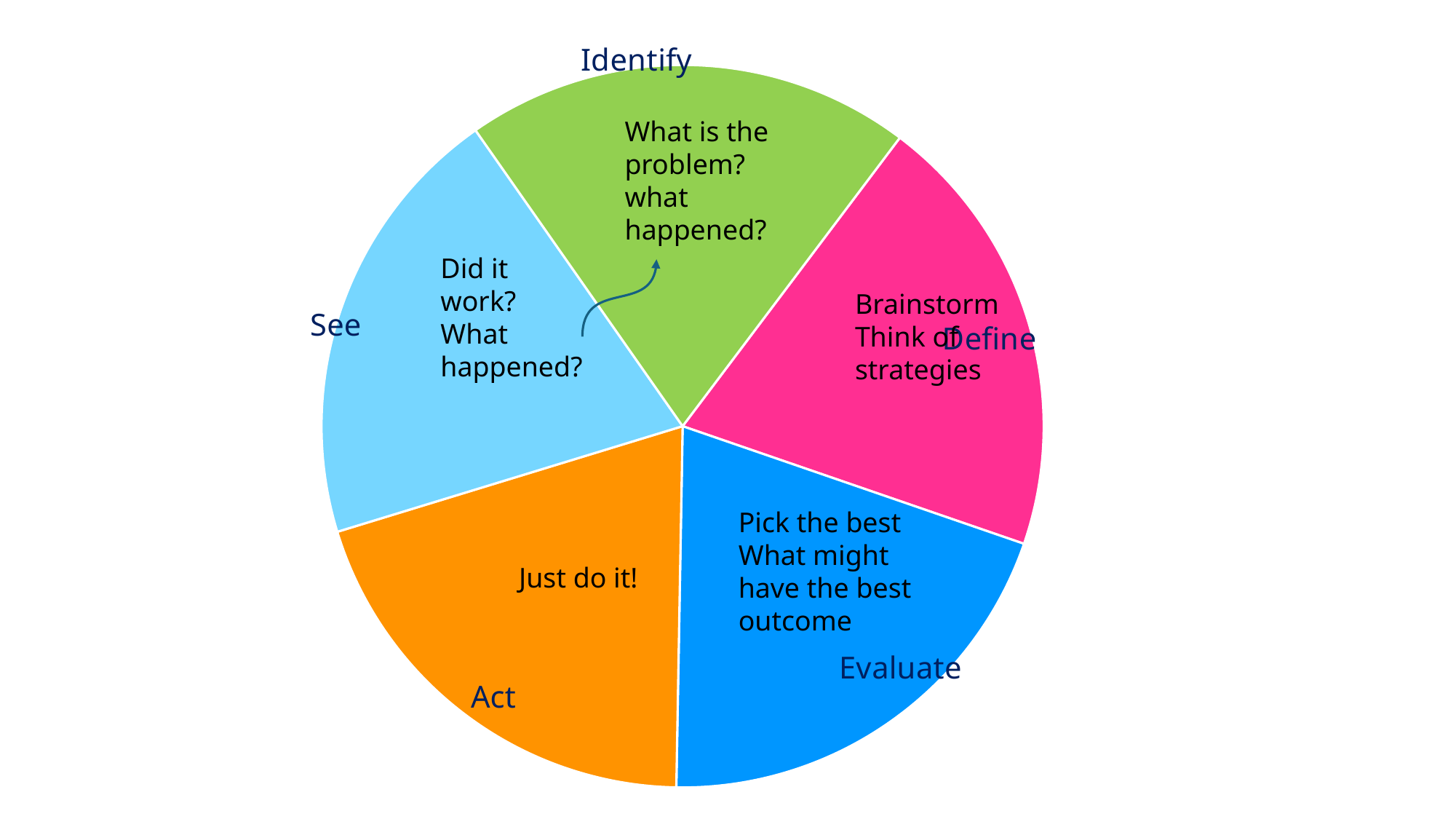
Which slice of the pie chart contains the text "Just do it!"? Act How many slices does the pie chart have? 5 Which slice of the pie chart contains the text "Brainstorm Think of strategies"? Define What colour is the Act slice of the pie chart? orange What colour is the Identify slice of the pie chart? green Which slice of the pie chart contains the text "Did it work? What happened?"? See Which slice of the pie chart contains the text "What is the problem? what happened?"? Identify What kind of chart is shown on the slide? pie chart Which slice of the pie chart contains the text "Pick the best What might have the best outcome"? Evaluate